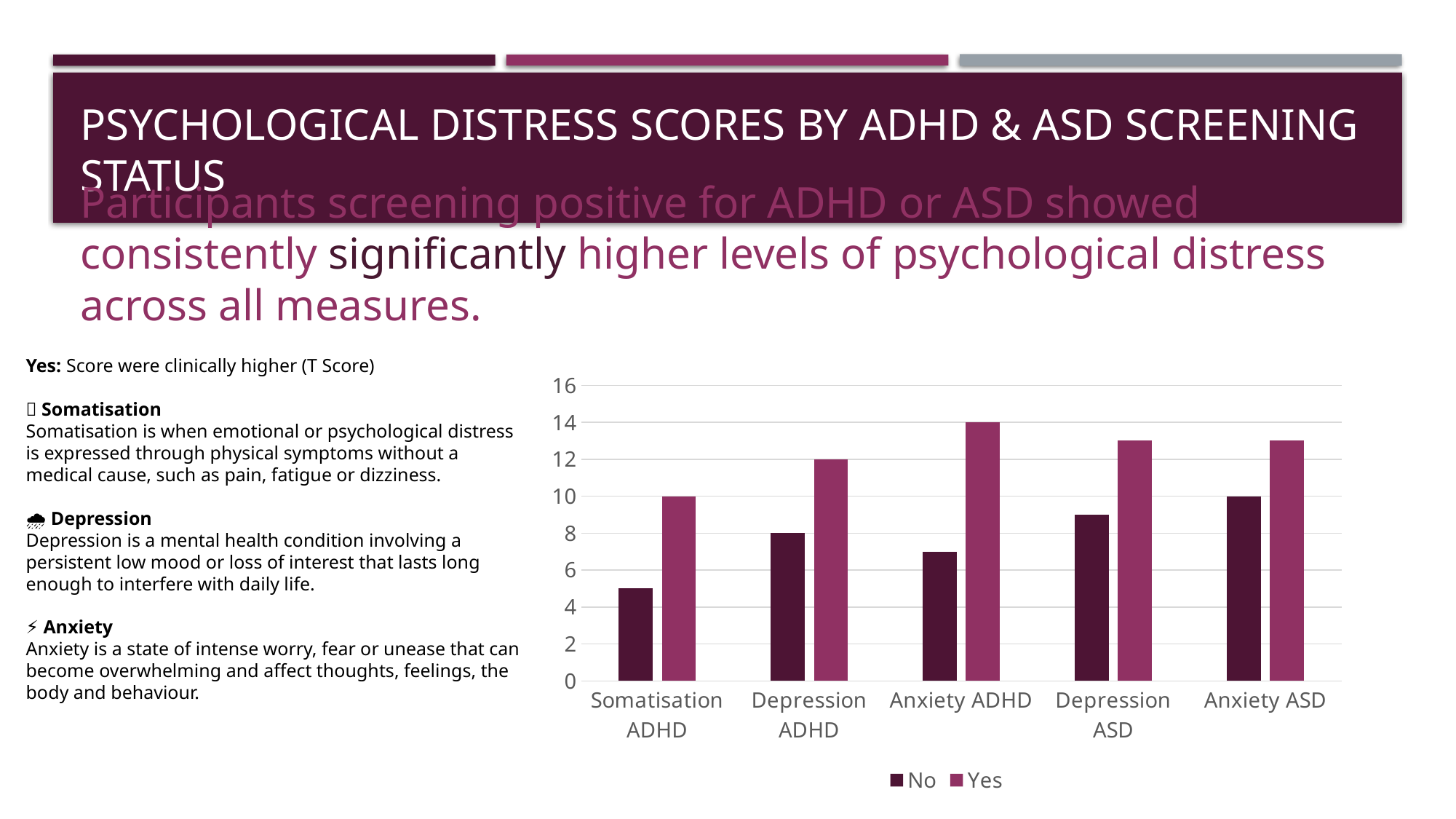
What is the difference between the Yes and No bars for Depression ADHD? 4 Is the No value for Somatisation ADHD greater or less than 6? less What is the value of the Yes bar for Somatisation ADHD? 10 Which category has the highest Yes value? Anxiety ADHD How many series does the chart legend list? 2 What is the value of the Yes bar for Anxiety ADHD? 14 What type of chart is shown on the slide? bar chart What is the value of the No bar for Depression ADHD? 8 Is the Yes value for Depression ASD greater or less than 12? greater Which category has the lowest No value? Somatisation ADHD How many categories are shown on the x axis of the chart? 5 What is the value of the Yes bar for Depression ADHD? 12